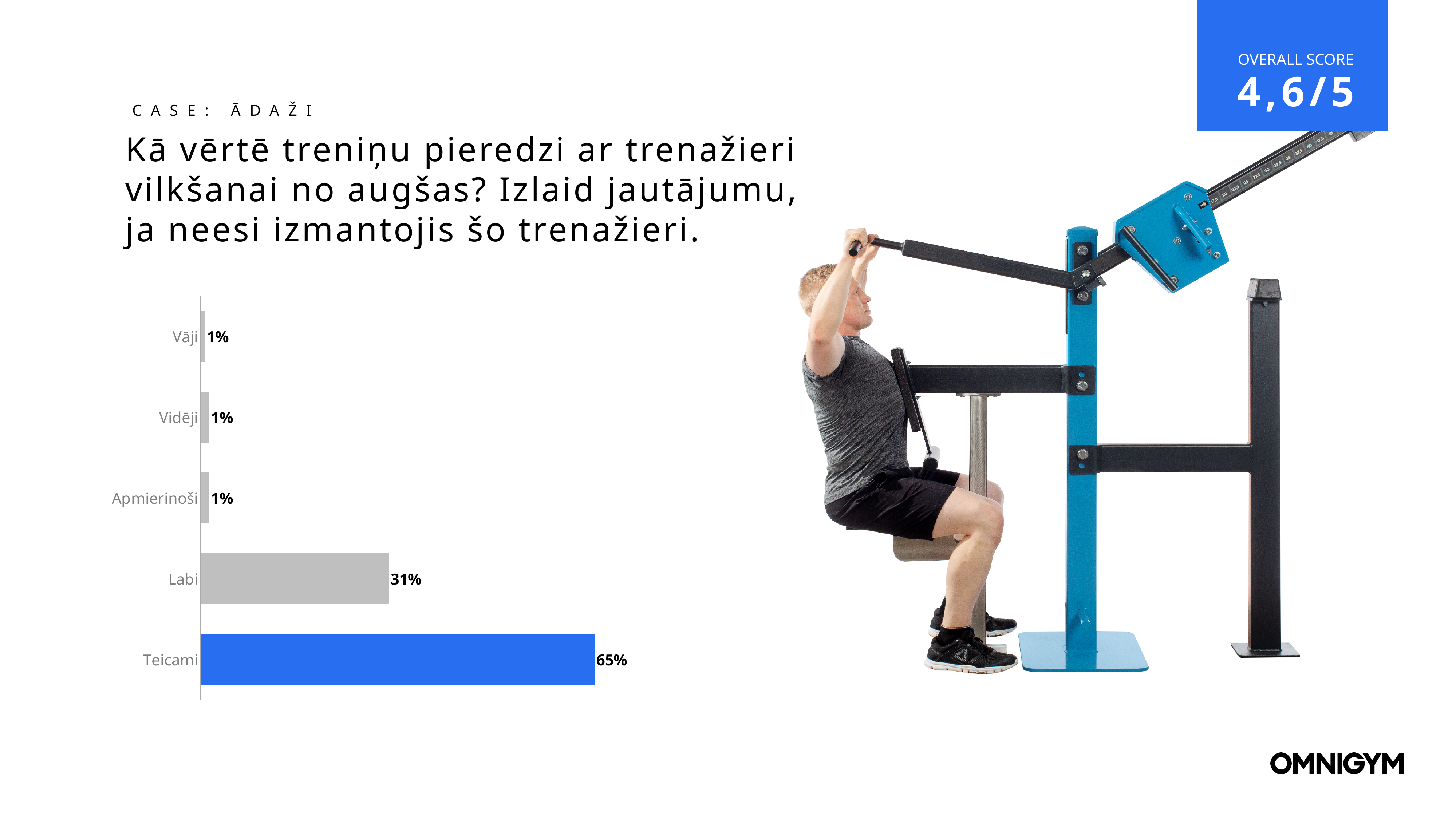
What is the value for Labi? 31% What is the value for Vāji? 1% How many categories does the chart show? 5 What is the difference between the values for Teicami and Labi? 34% What is the value for Apmierinoši? 1% Which is larger, the value for Labi or the value for Vidēji? Labi Which category has the highest value? Teicami What is the value for Teicami? 65% How many categories have a value of 1%? 3 What kind of chart is shown on the slide? Bar chart What overall score is shown on the slide? 4,6/5 Which bar is coloured blue? Teicami